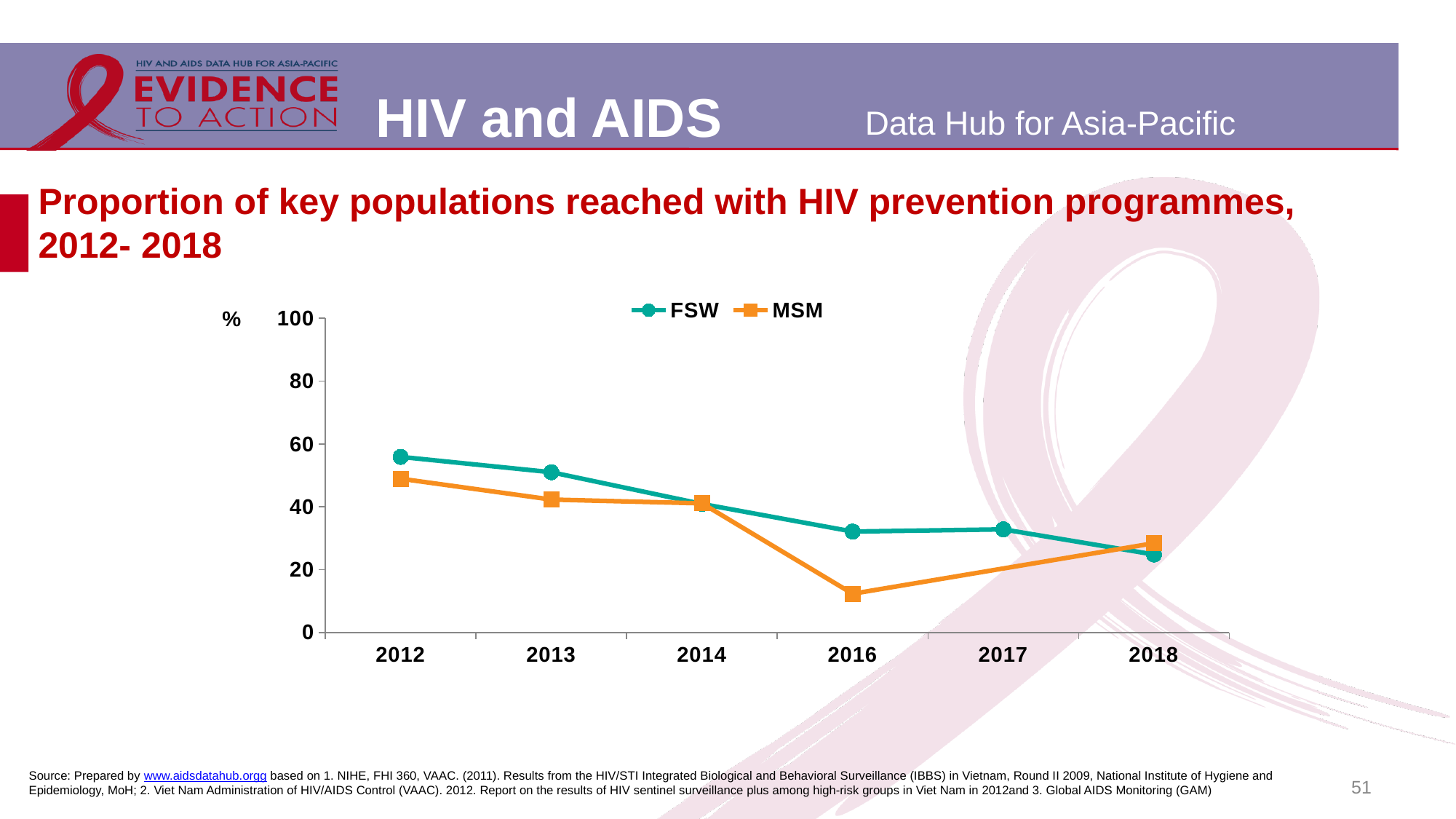
In which year is the MSM value lowest? 2016 In which year is the FSW value highest? 2012 How many series does the legend list? 2 Is the FSW value for 2016 greater or less than 20? greater In 2012, which series has the higher value, FSW or MSM? FSW How many years are shown on the x axis? 6 Is the FSW value for 2012 greater or less than 40? greater Does the FSW value generally rise or fall from 2012 to 2018? fall Which series is shown with the orange line and square markers? MSM Is the MSM value for 2016 greater or less than 20? less What kind of chart is shown on the slide? Line chart